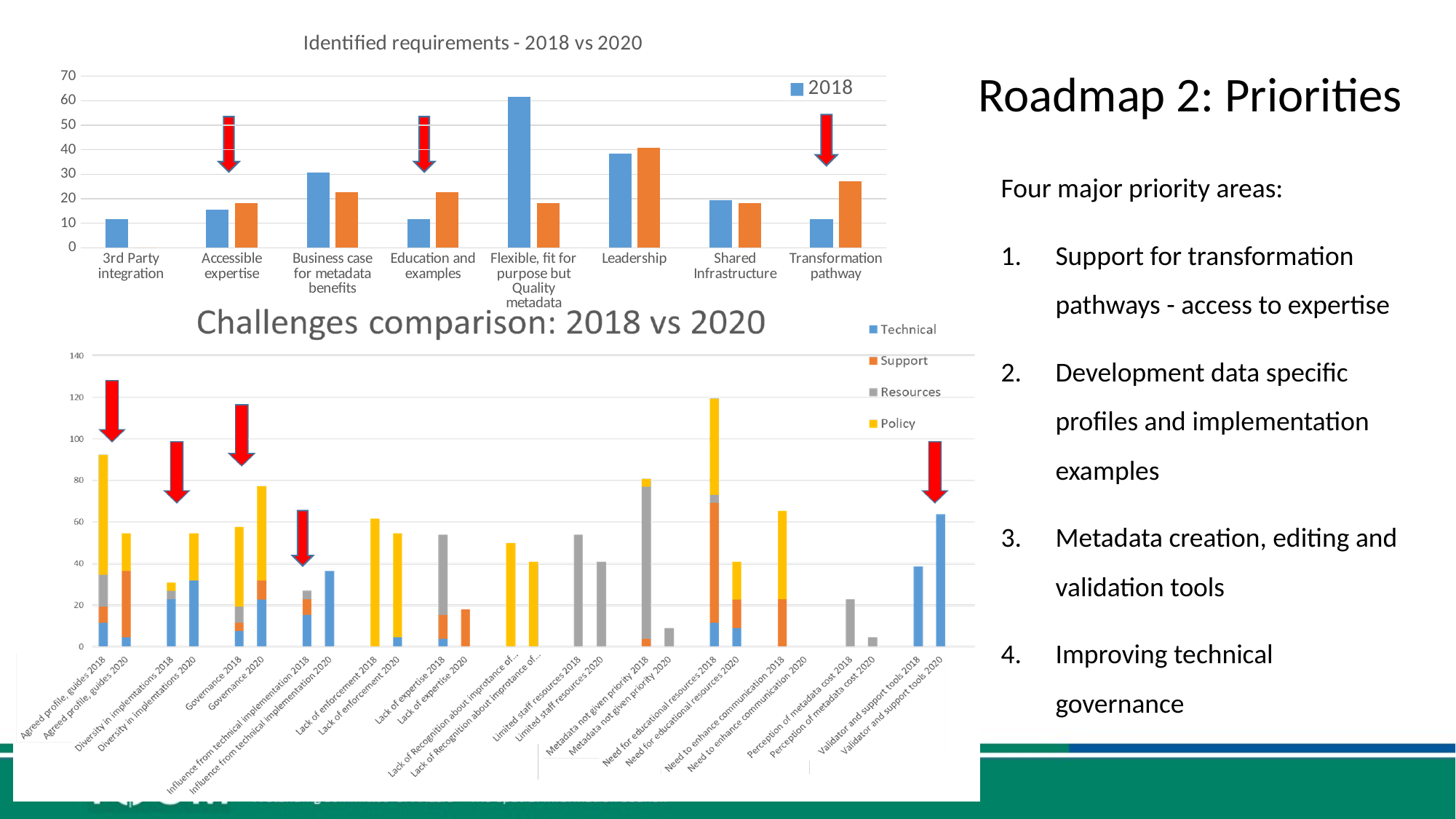
In the 'Challenges comparison: 2018 vs 2020' chart, how many series does the legend list? 4 In the 'Challenges comparison: 2018 vs 2020' chart, which bar has the highest total? Need for educational resources 2018 In the 'Identified requirements - 2018 vs 2020' chart, how many requirement categories are shown on the x axis? 8 In the 'Identified requirements - 2018 vs 2020' chart, which is larger for 'Business case for metadata benefits': the 2018 bar or the 2020 bar? 2018 In the 'Identified requirements - 2018 vs 2020' chart, which is larger for 'Transformation pathway': the 2018 bar or the 2020 bar? 2020 In the 'Identified requirements - 2018 vs 2020' chart, is the 2018 value for 'Leadership' greater or less than 30? greater In the 'Challenges comparison: 2018 vs 2020' chart, is the total for 'Agreed profile, guides 2018' greater or less than 80? greater In the 'Identified requirements - 2018 vs 2020' chart, which category has the highest 2018 value? Flexible, fit for purpose but Quality metadata In the 'Challenges comparison: 2018 vs 2020' chart, what are the legend entries? Technical, Support, Resources, Policy In the 'Identified requirements - 2018 vs 2020' chart, is the 2020 value for 'Education and examples' greater or less than 30? less In the 'Identified requirements - 2018 vs 2020' chart, what kind of chart is shown? Bar chart